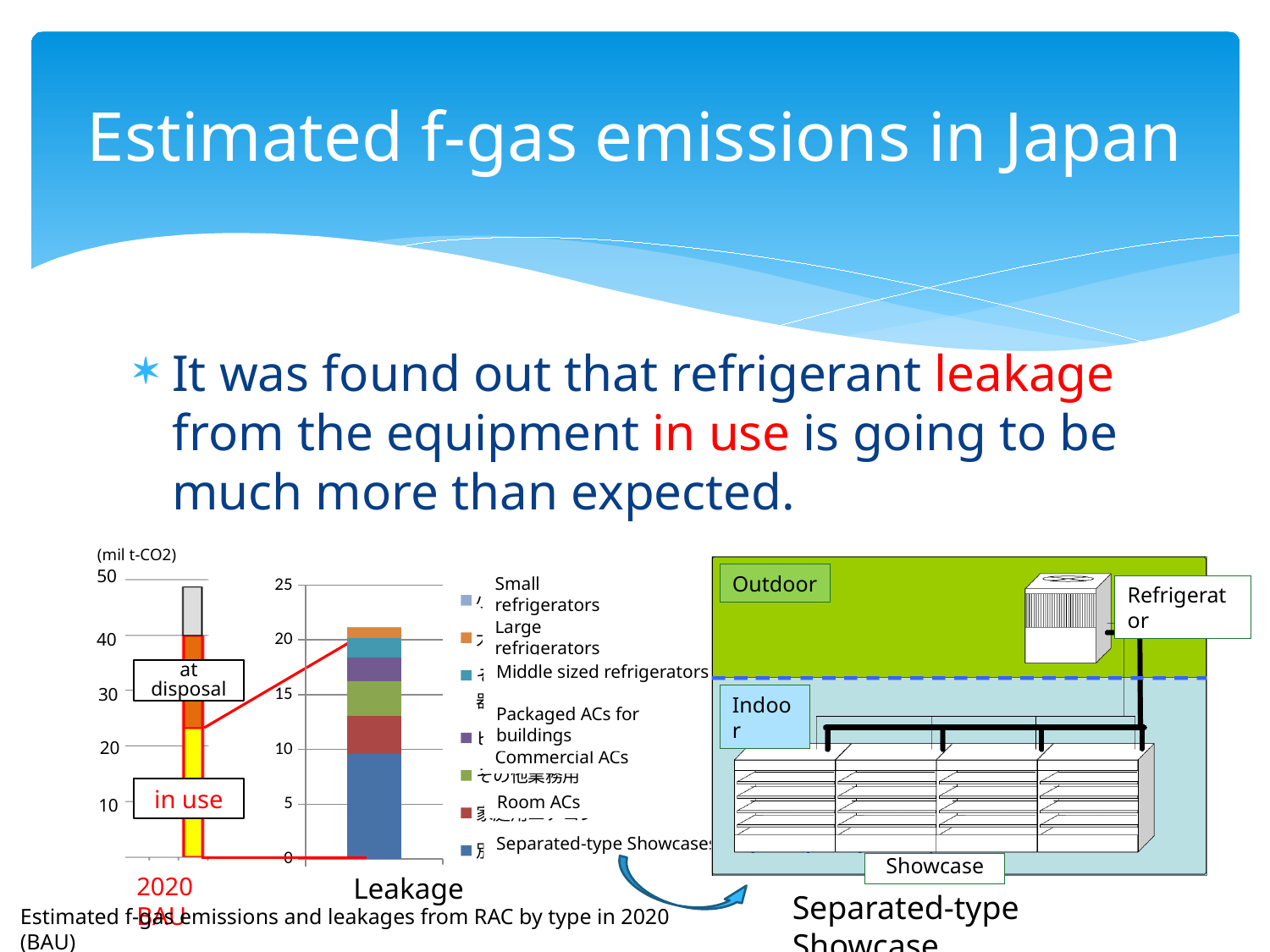
What kind of chart is the Leakage chart on the right? bar chart How many bars are plotted in the Leakage chart? 1 In the Leakage chart, is the total height of the stacked bar greater or less than 25? less What is the category label under the bar in the left chart? 2020 BAU In the Leakage chart, is the total height of the stacked bar greater or less than 20? greater In the Leakage chart, which segment is larger: Separated-type Showcases or Room ACs? Separated-type Showcases In the Leakage chart, which category has the largest segment in the stacked bar? Separated-type Showcases How many series does the legend of the Leakage chart list? 7 What unit is shown above the y-axis of the left chart? (mil t-CO2) In the left chart (2020 BAU), is the total height of the stacked bar greater or less than 40? greater